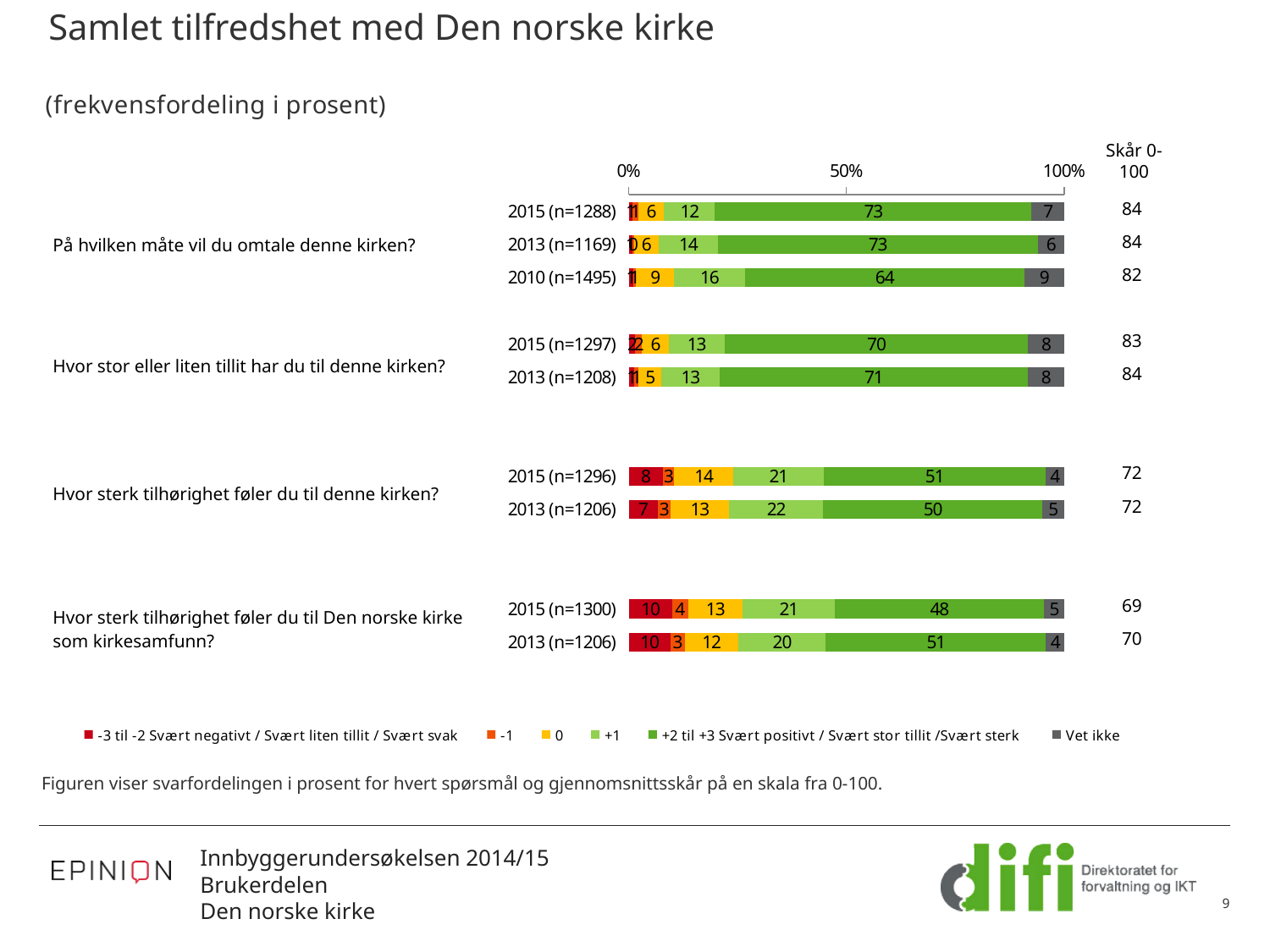
For 'Hvor sterk tilhørighet føler du til denne kirken?', which year has the larger '+2 til +3' percentage, 2015 (n=1296) or 2013 (n=1206)? 2015 (n=1296) What is the 'Skår 0-100' value for 'Hvor stor eller liten tillit har du til denne kirken?' in 2015 (n=1297)? 83 What percentage answered '+2 til +3' for 'På hvilken måte vil du omtale denne kirken?' in 2015 (n=1288)? 73 How many series does the legend list? 6 What percentage answered '-3 til -2' for 'Hvor sterk tilhørighet føler du til Den norske kirke som kirkesamfunn?' in 2015 (n=1300)? 10 How many bars are plotted in the chart? 11 Which row has the lowest 'Skår 0-100' value? 2015 (n=1300), Hvor sterk tilhørighet føler du til Den norske kirke som kirkesamfunn? What percentage answered 'Vet ikke' for 'På hvilken måte vil du omtale denne kirken?' in 2010 (n=1495)? 9 Which legend entry is shown in dark green? +2 til +3 Svært positivt / Svært stor tillit /Svært sterk Did the 'Skår 0-100' value for 'Hvor sterk tilhørighet føler du til Den norske kirke som kirkesamfunn?' rise or fall from 2013 to 2015? Fall What is the difference in the '+2 til +3' percentage between 2013 (n=1169) and 2010 (n=1495) for 'På hvilken måte vil du omtale denne kirken?' 9 What type of chart is shown on the slide? Stacked bar chart